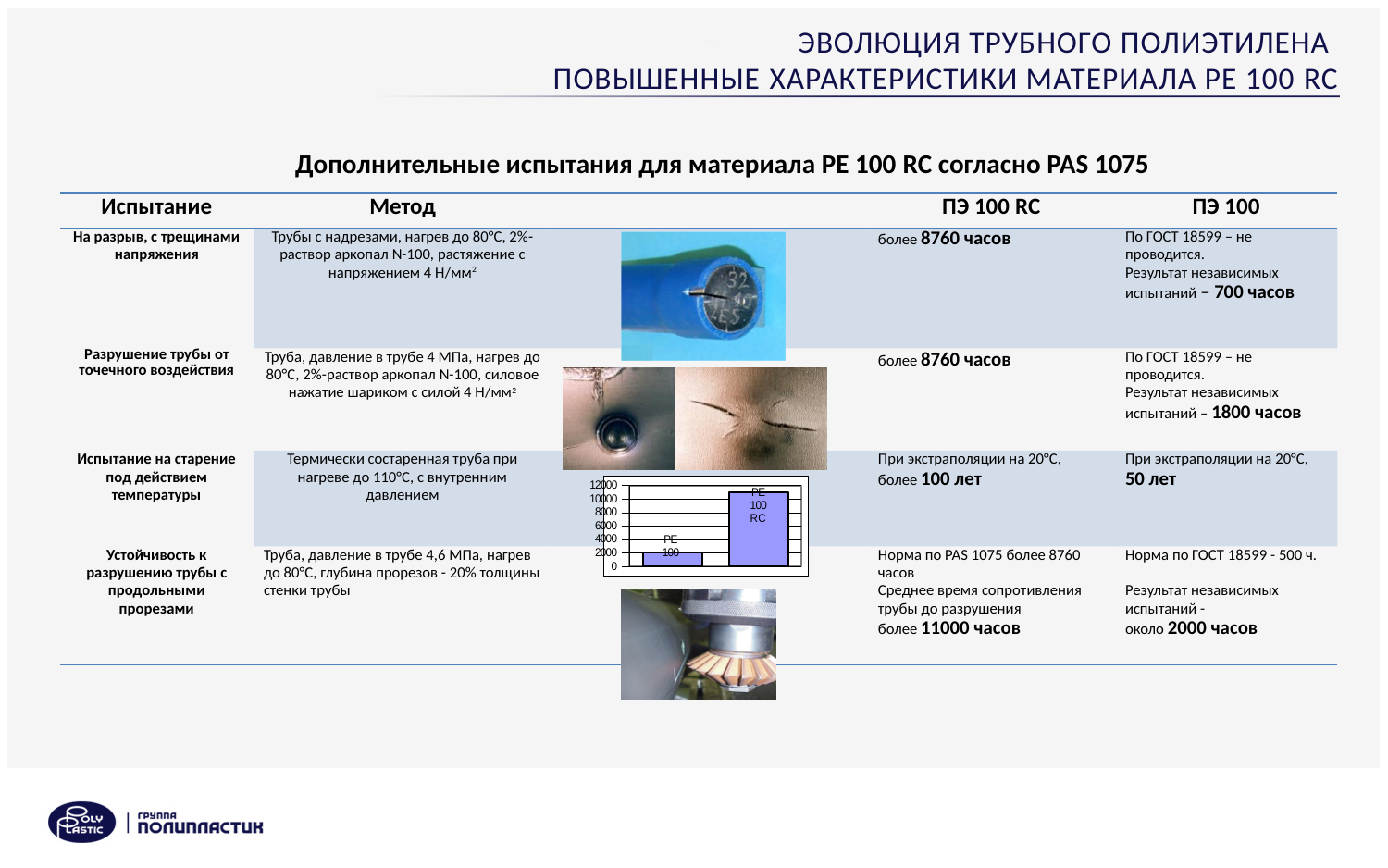
Which bar in the chart is the highest? PE 100 RC How many bars does the chart show? 2 Which is larger in the chart, the value for PE 100 or the value for PE 100 RC? PE 100 RC What are the labels of the two bars in the chart? PE 100 and PE 100 RC Is the value for PE 100 in the chart greater or less than 4000? less Which bar in the chart is the lowest? PE 100 Is the value for PE 100 RC in the chart greater or less than 8000? greater What is the highest tick value shown on the chart's vertical axis? 12000 Is the value for PE 100 RC in the chart greater or less than 6000? greater What kind of chart is shown on the slide? bar chart